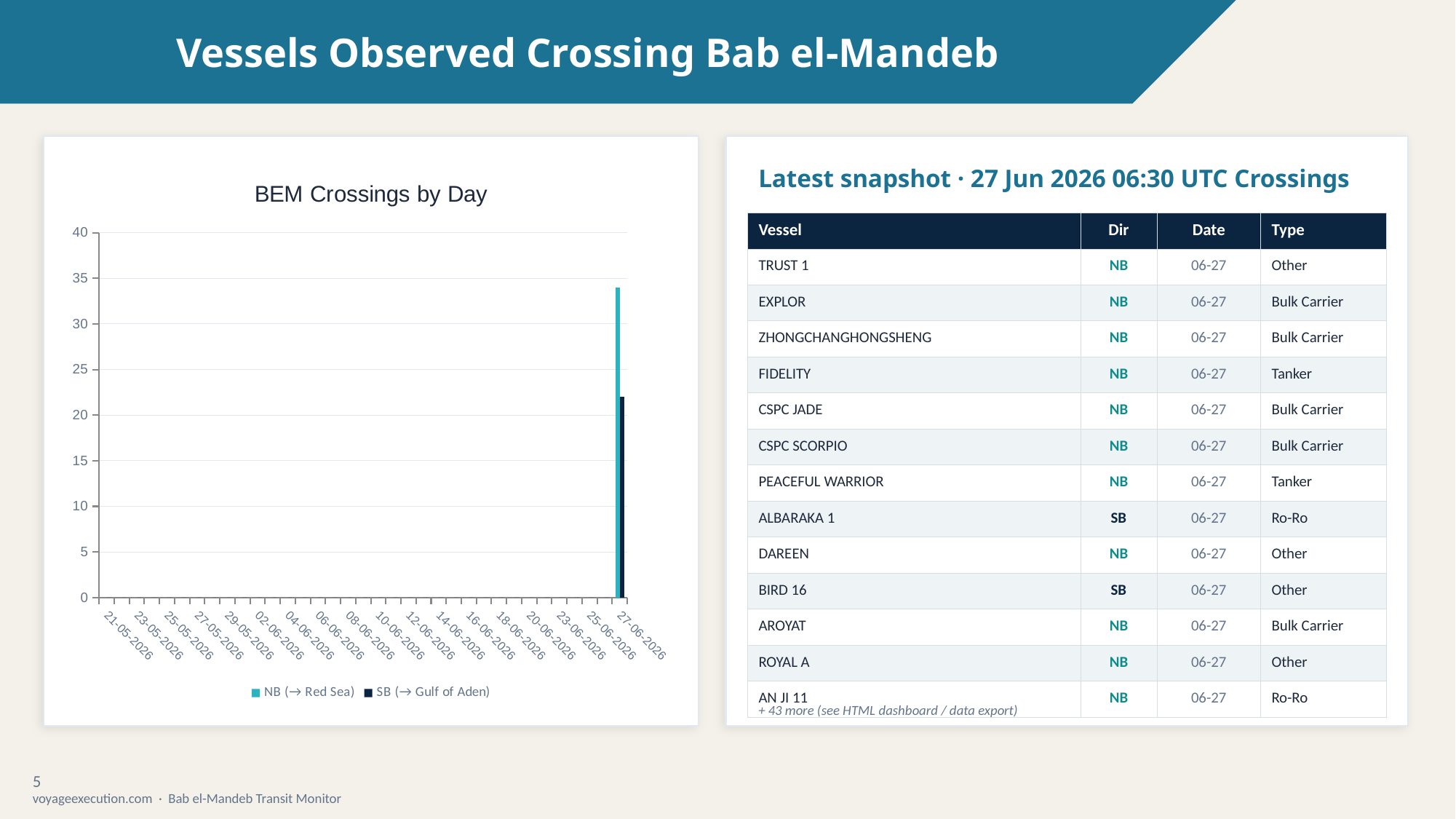
In "BEM Crossings by Day", is the SB (→ Gulf of Aden) value for 27-06-2026 greater or less than 20? greater In "BEM Crossings by Day", is the NB (→ Red Sea) value for 27-06-2026 greater or less than 30? greater In "BEM Crossings by Day", what are the two legend entries? NB (→ Red Sea) and SB (→ Gulf of Aden) In "BEM Crossings by Day", is the SB (→ Gulf of Aden) value for 27-06-2026 greater or less than 25? less In "BEM Crossings by Day", which series has the taller bar on 27-06-2026, NB (→ Red Sea) or SB (→ Gulf of Aden)? NB (→ Red Sea) How many series does the legend of "BEM Crossings by Day" list? 2 In "BEM Crossings by Day", on which date do the bars appear? 27-06-2026 What kind of chart is "BEM Crossings by Day"? bar chart What is the title of the chart on the left of the slide? BEM Crossings by Day In "BEM Crossings by Day", what is the highest value shown on the vertical axis? 40